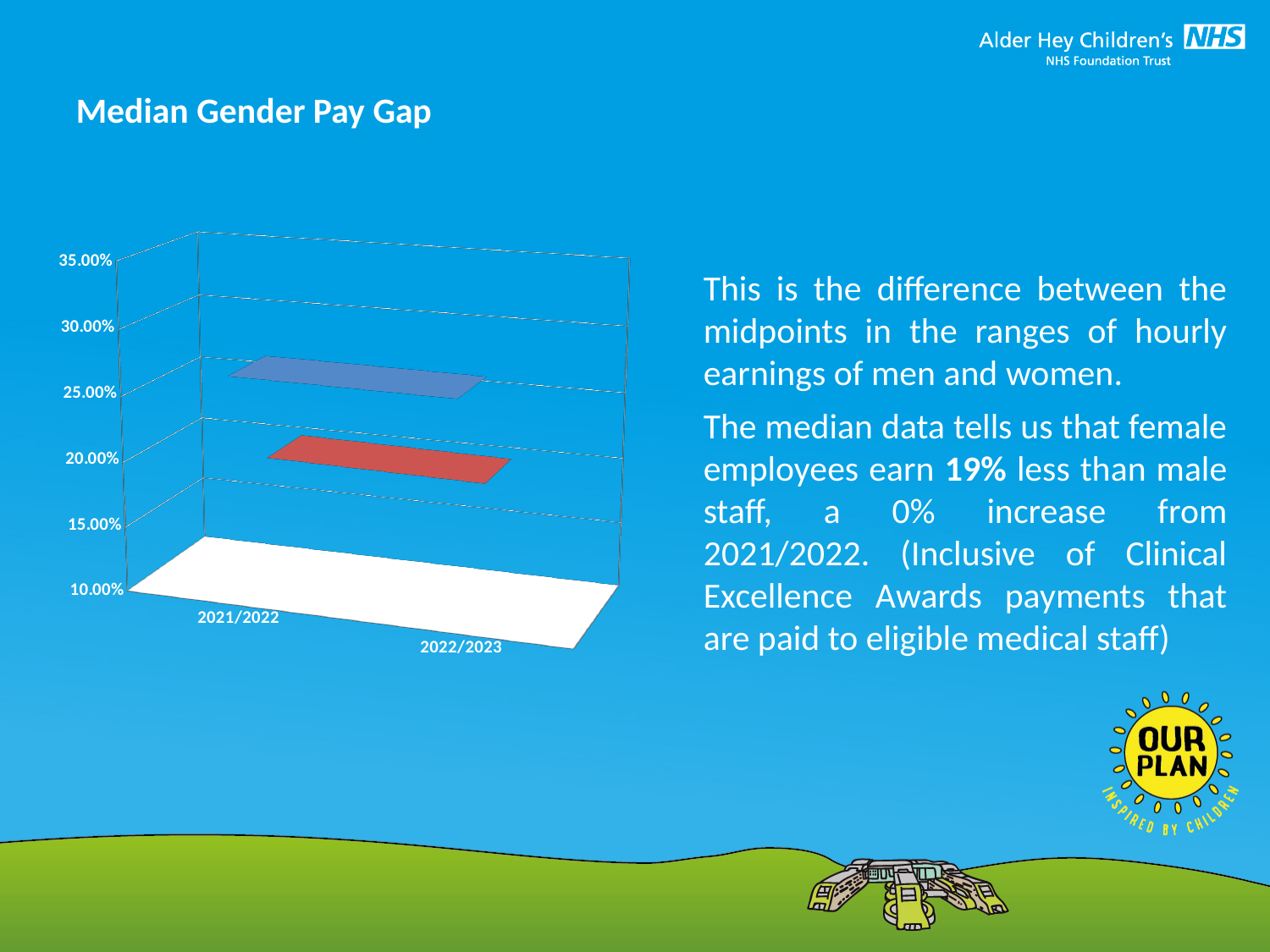
Is the value plotted for 2022/2023 greater or less than 10.00%? greater Is the value plotted for 2021/2022 greater or less than 35.00%? less What is the title of the chart? Median Gender Pay Gap What is the lowest value shown on the chart's vertical axis? 10.00% What is the highest value shown on the chart's vertical axis? 35.00% Is the value plotted for 2021/2022 greater or less than 10.00%? greater How many categories are shown on the chart's category axis? 2